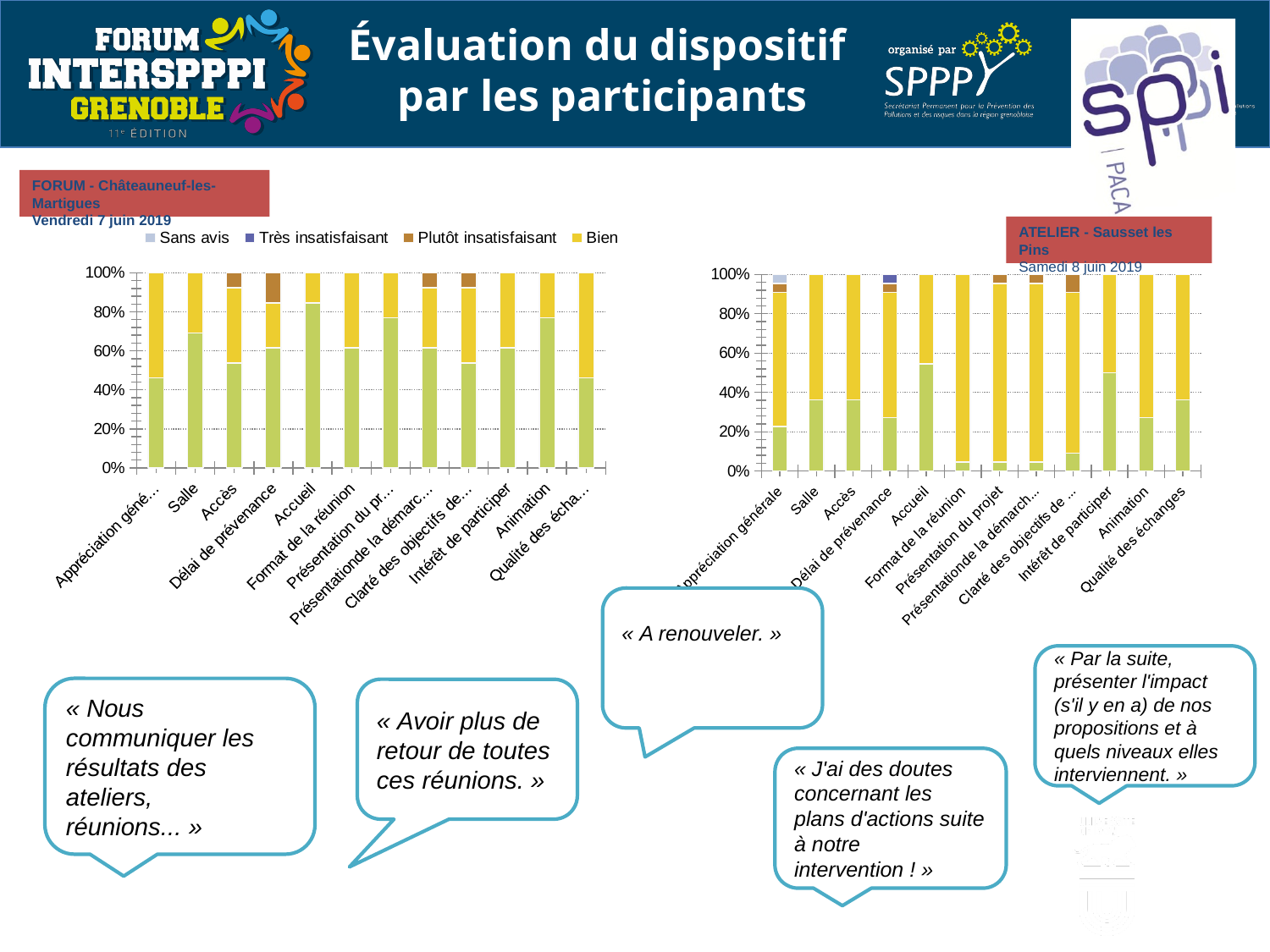
In the ATELIER - Sausset les Pins chart, is the green segment for Salle greater or less than 40%? less In the ATELIER - Sausset les Pins chart, what is the total height of the stacked bar for Animation? 100% In the FORUM - Châteauneuf-les-Martigues chart, is the green segment for Salle greater or less than 60%? greater In the ATELIER - Sausset les Pins chart, is the green segment for Format de la réunion greater or less than 20%? less How many series does the legend at the top of the slide list? 4 What kind of chart is used on the left (FORUM - Châteauneuf-les-Martigues) side of the slide? Stacked bar chart Which colour represents the series 'Bien' in the legend? Yellow In the ATELIER - Sausset les Pins chart, how many categories are shown on the x axis? 12 In the FORUM - Châteauneuf-les-Martigues chart, which category has the largest green segment? Accueil In the ATELIER - Sausset les Pins chart, which has the larger green segment, Accueil or Salle? Accueil In the FORUM - Châteauneuf-les-Martigues chart, how many categories are shown on the x axis? 12